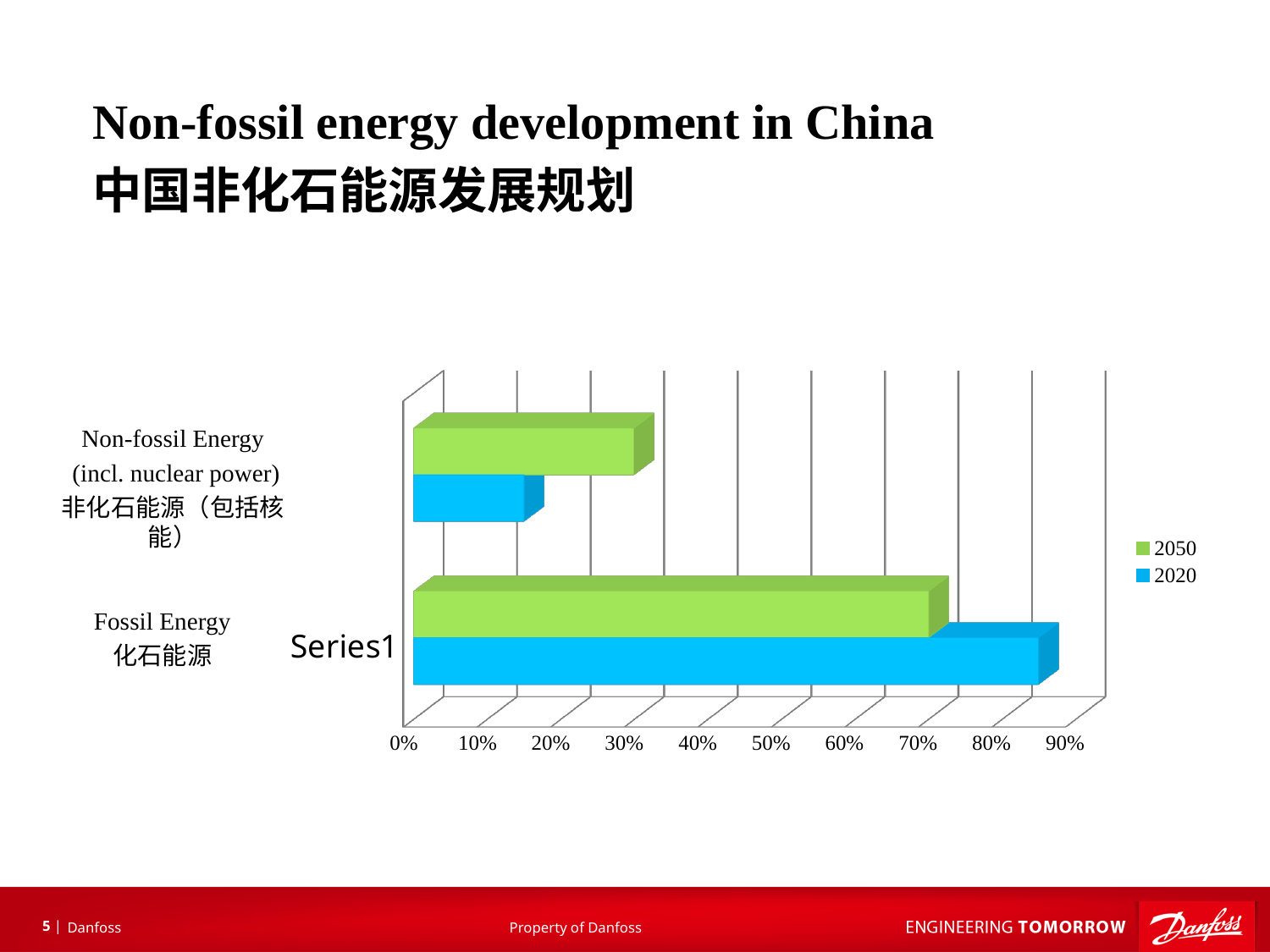
For Fossil Energy, which series has the larger value, 2020 or 2050? 2020 What kind of chart is shown on the slide? bar chart For Non-fossil Energy, which series has the larger value, 2020 or 2050? 2050 Which category has the longest bar for the 2020 series? Fossil Energy Which category has the shortest bar for the 2050 series? Non-fossil Energy Is the 2020 value for Fossil Energy greater or less than 80%? greater How many series does the legend list? 2 Which series does the blue colour represent in the legend? 2020 Is the 2020 value for Non-fossil Energy greater or less than 20%? less Is the 2050 value for Fossil Energy greater or less than 80%? less How many categories are shown on the chart? 2 Which series does the green colour represent in the legend? 2050